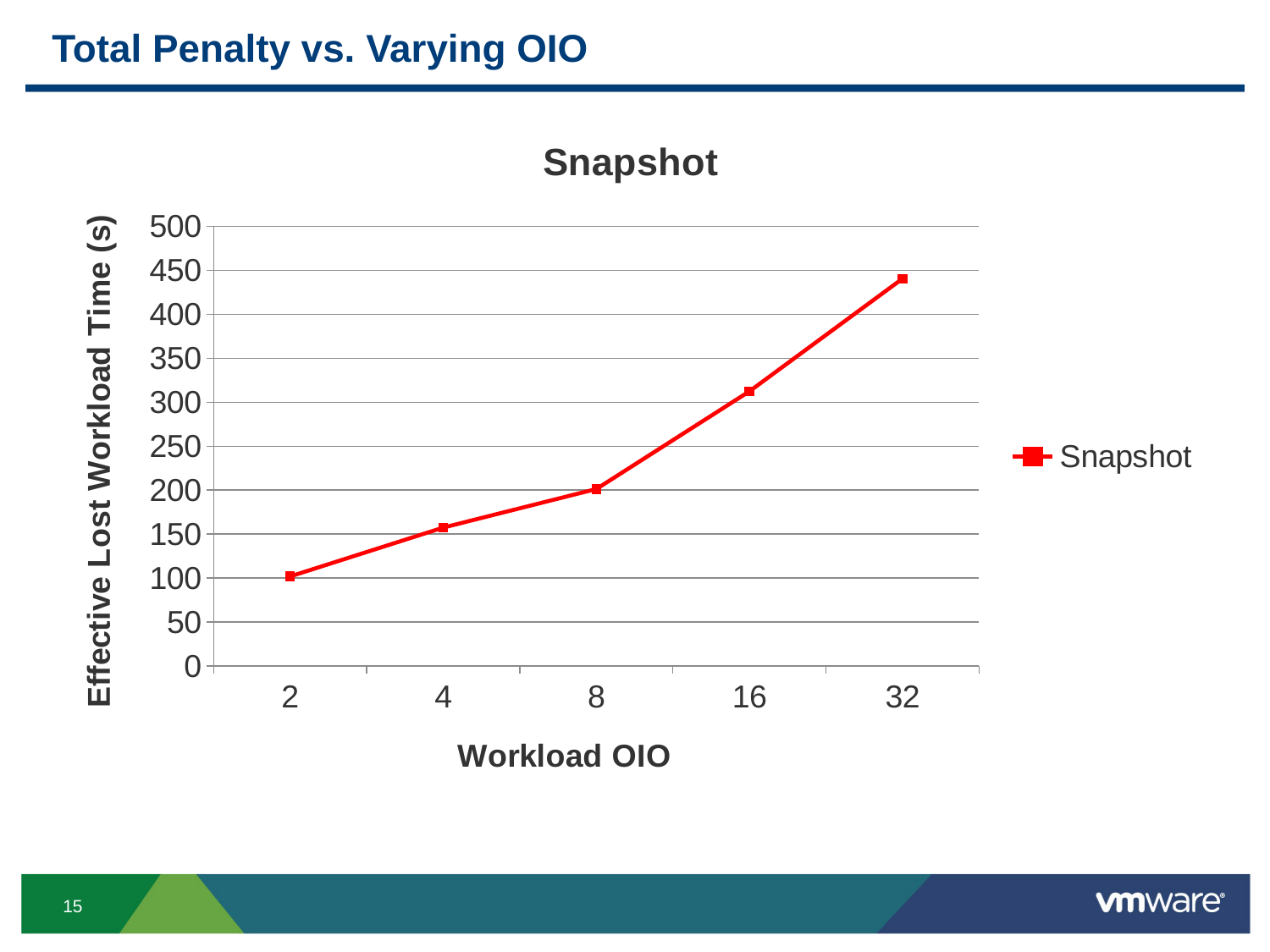
Which Workload OIO value has the highest Effective Lost Workload Time? 32 What is the label of the y axis? Effective Lost Workload Time (s) Which Workload OIO value has the lowest Effective Lost Workload Time? 2 What is the title of the chart? Snapshot Does the Effective Lost Workload Time rise or fall as Workload OIO increases from 2 to 32? rise Is the value for Workload OIO 16 greater or less than 350? less Which has the larger Effective Lost Workload Time, Workload OIO 8 or Workload OIO 16? 16 Is the value for Workload OIO 32 greater or less than 400? greater What kind of chart is shown on the slide? line chart How many Workload OIO values are plotted on the x axis? 5 Is the value for Workload OIO 4 greater or less than 200? less How many series does the legend list? 1